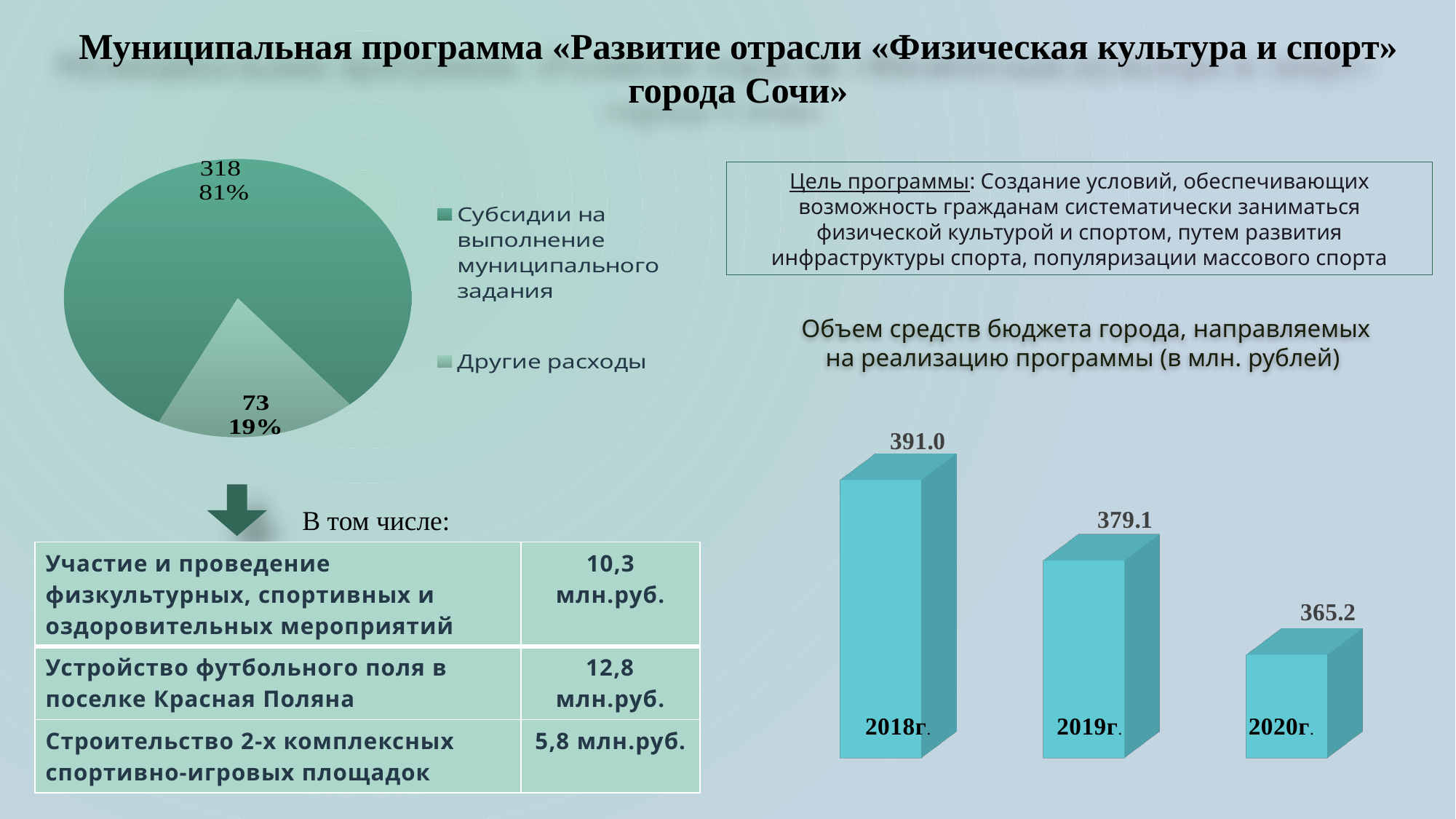
What kind of chart is the chart on the right («Объем средств бюджета города»)? bar chart In the pie chart on the left, what share of the pie does «Другие расходы» take? 19% In the pie chart on the left, what value is shown for «Субсидии на выполнение муниципального задания»? 318 In the pie chart on the left, what is the difference between the values for «Субсидии на выполнение муниципального задания» and «Другие расходы»? 245 In the bar chart on the right («Объем средств бюджета города»), which year has the lowest value? 2020г. In the pie chart on the left, how many entries does the legend list? 2 In the pie chart on the left, what share of the pie does «Субсидии на выполнение муниципального задания» take? 81% In the bar chart on the right («Объем средств бюджета города»), what is the value for 2018г.? 391.0 In the pie chart on the left, which slice is larger: «Субсидии на выполнение муниципального задания» or «Другие расходы»? Субсидии на выполнение муниципального задания In the bar chart on the right («Объем средств бюджета города»), do the values rise or fall from 2018г. to 2020г.? fall In the bar chart on the right («Объем средств бюджета города»), what is the value for 2020г.? 365.2 In the pie chart on the left, what value is shown for «Другие расходы»? 73